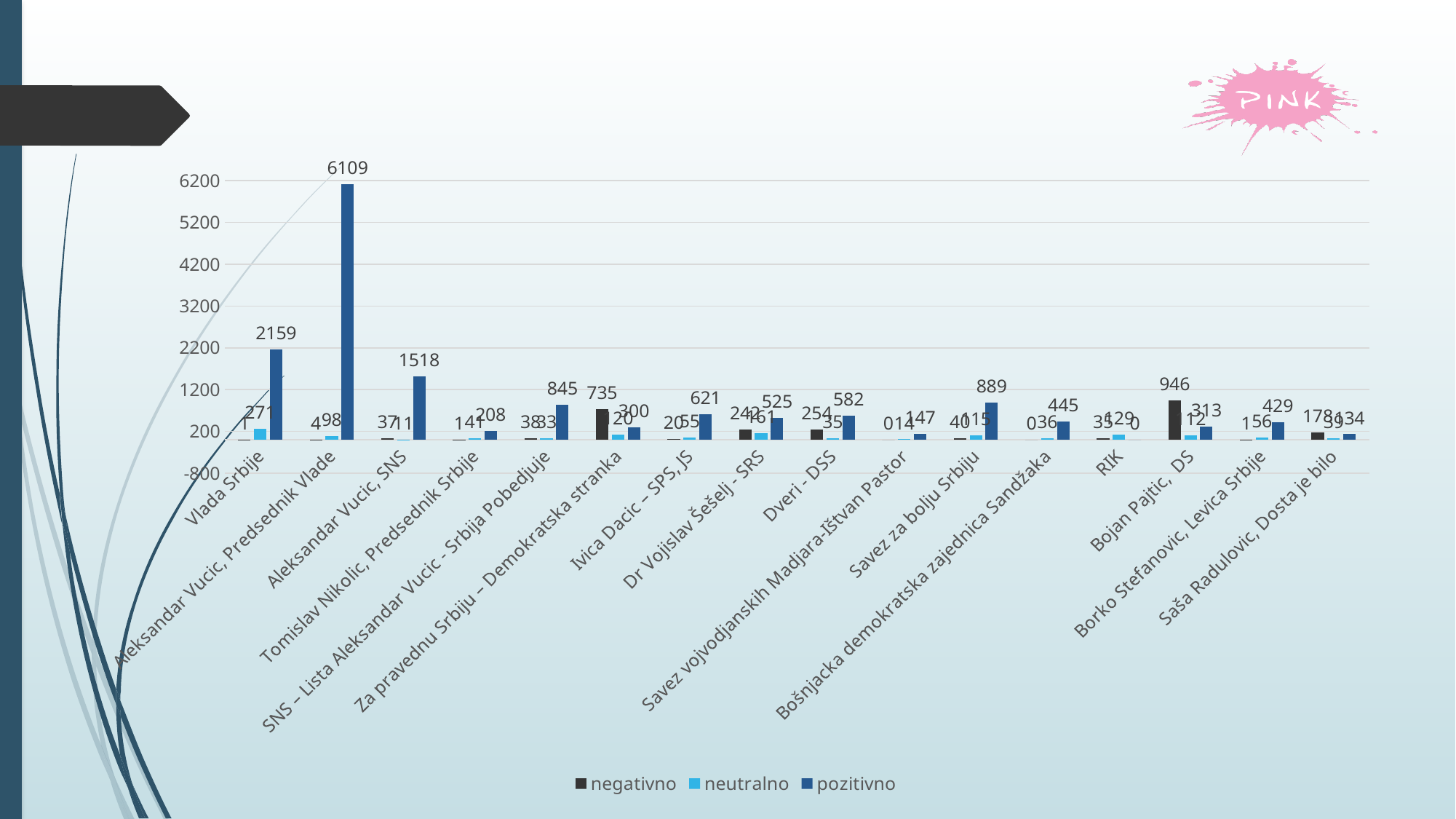
What is the pozitivno value for Vlada Srbije? 2159 What is the negativno value for Za pravednu Srbiju – Demokratska stranka? 735 What is the pozitivno value for Savez za bolju Srbiju? 889 What is the negativno value for Bojan Pajtic, DS? 946 What kind of chart is shown on the slide? bar chart How many series does the legend list? 3 What is the pozitivno value for Aleksandar Vucic, Predsednik Vlade? 6109 Which is larger: the pozitivno value for Savez za bolju Srbiju or for Dveri - DSS? Savez za bolju Srbiju Which category has the highest pozitivno value? Aleksandar Vucic, Predsednik Vlade What is the difference between the pozitivno values for Aleksandar Vucic, Predsednik Vlade and Vlada Srbije? 3950 Which series is shown in light blue in the legend? neutralno How many categories are shown on the x axis? 16